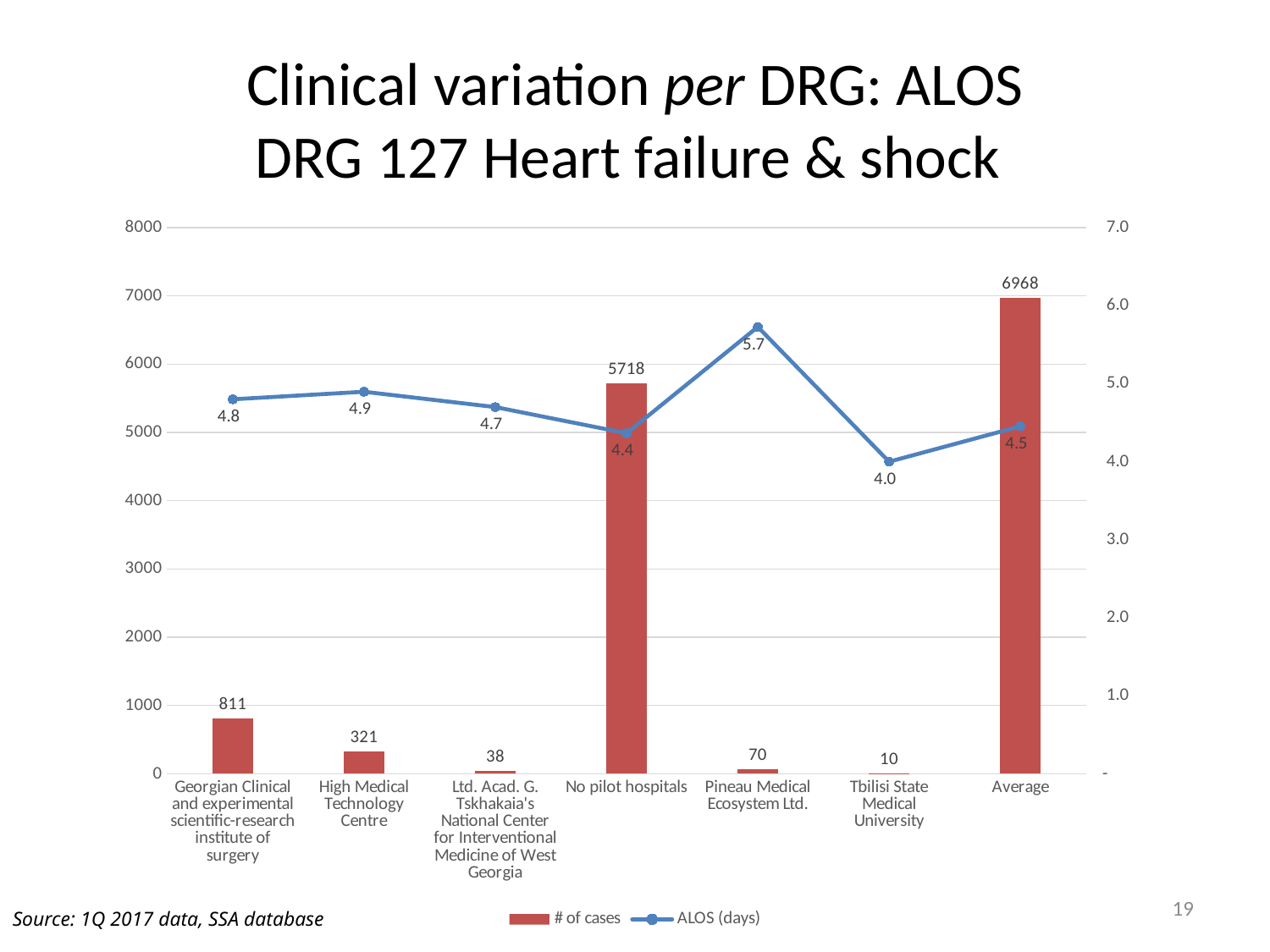
What is the difference in number of cases between Average and No pilot hospitals? 1250 How many series does the legend list? 2 How many cases are shown for No pilot hospitals? 5718 Which category has the highest number of cases? Average How many categories are shown on the x axis? 7 Which category has the highest ALOS (days)? Pineau Medical Ecosystem Ltd. What is the number of cases for High Medical Technology Centre? 321 What series is plotted as the blue line? ALOS (days) Which has more cases, Georgian Clinical and experimental scientific-research institute of surgery or High Medical Technology Centre? Georgian Clinical and experimental scientific-research institute of surgery What is the ALOS (days) for Tbilisi State Medical University? 4.0 What is the ALOS (days) for Pineau Medical Ecosystem Ltd.? 5.7 Which category has the lowest number of cases? Tbilisi State Medical University